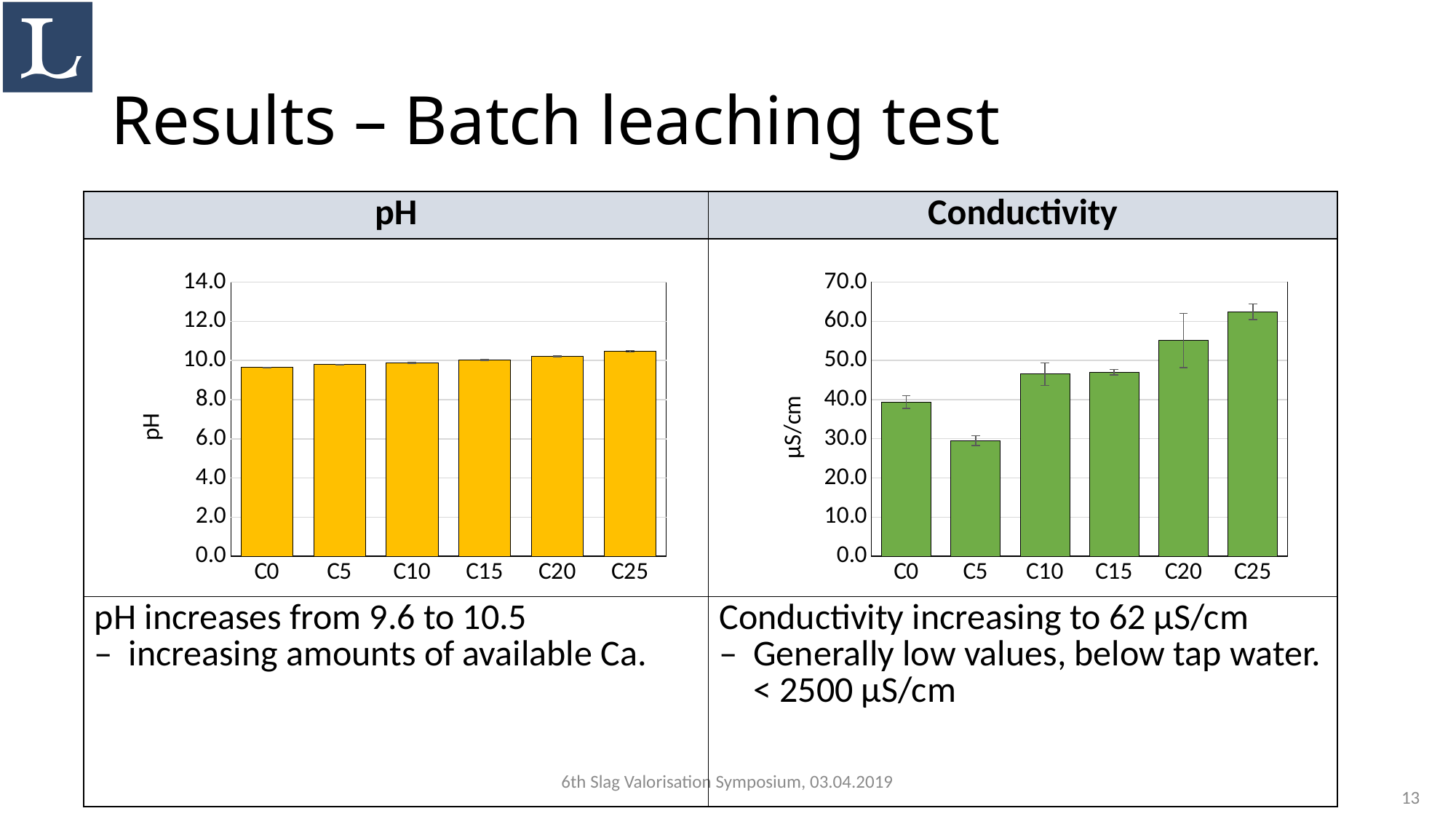
In the pH chart, is the value for C0 greater or less than 8.0? greater What kind of chart is the pH chart on the left? bar chart In the Conductivity chart, which is larger, the value for C20 or the value for C5? C20 How many categories are shown on the x axis of the Conductivity chart? 6 In the pH chart, do the values rise or fall from C0 to C25? rise What is the y-axis label of the Conductivity chart? µS/cm In the Conductivity chart, is the value for C10 greater or less than 40.0? greater In the Conductivity chart, is the value for C20 greater or less than 50.0? greater In the Conductivity chart, which category has the lowest value? C5 In the Conductivity chart, which category has the highest value? C25 In the pH chart, which category has the highest value? C25